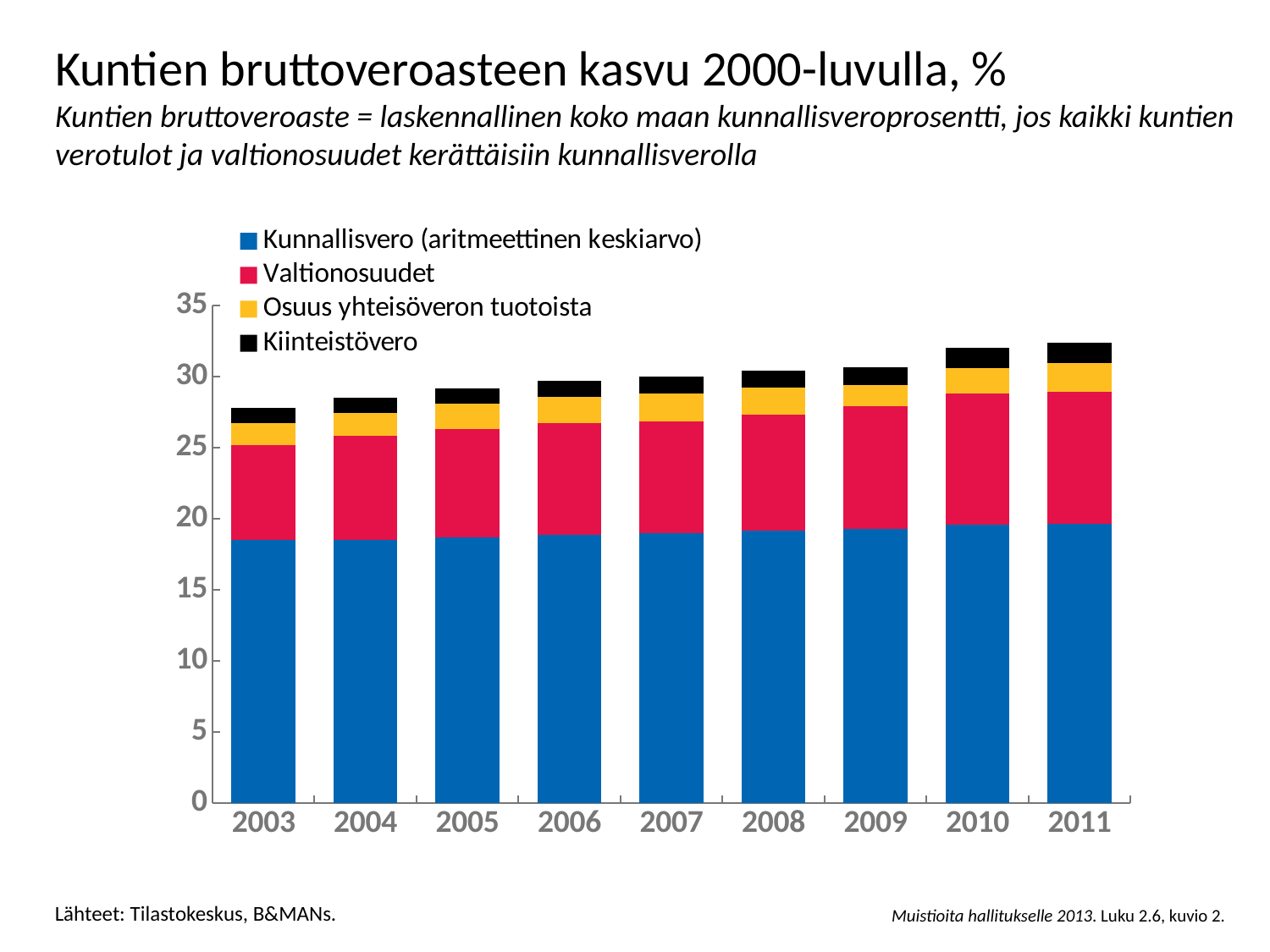
Is the total bar for 2011 greater or less than 30? greater Do the total bar heights rise or fall from 2003 to 2011? Rise How many series does the chart's legend list? 4 What is the title of the chart on the slide? Kuntien bruttoveroasteen kasvu 2000-luvulla, % Which year has the highest total bar in the chart? 2011 Is the total bar for 2003 greater or less than 30? less Which year has the larger total bar, 2003 or 2011? 2011 Which year has the lowest total bar in the chart? 2003 How many years are shown on the x axis of the chart? 9 Is the Kunnallisvero (aritmeettinen keskiarvo) value for 2003 greater or less than 20? less What kind of chart is shown on the slide? Stacked bar chart Which series is shown in black in the chart's legend? Kiinteistövero